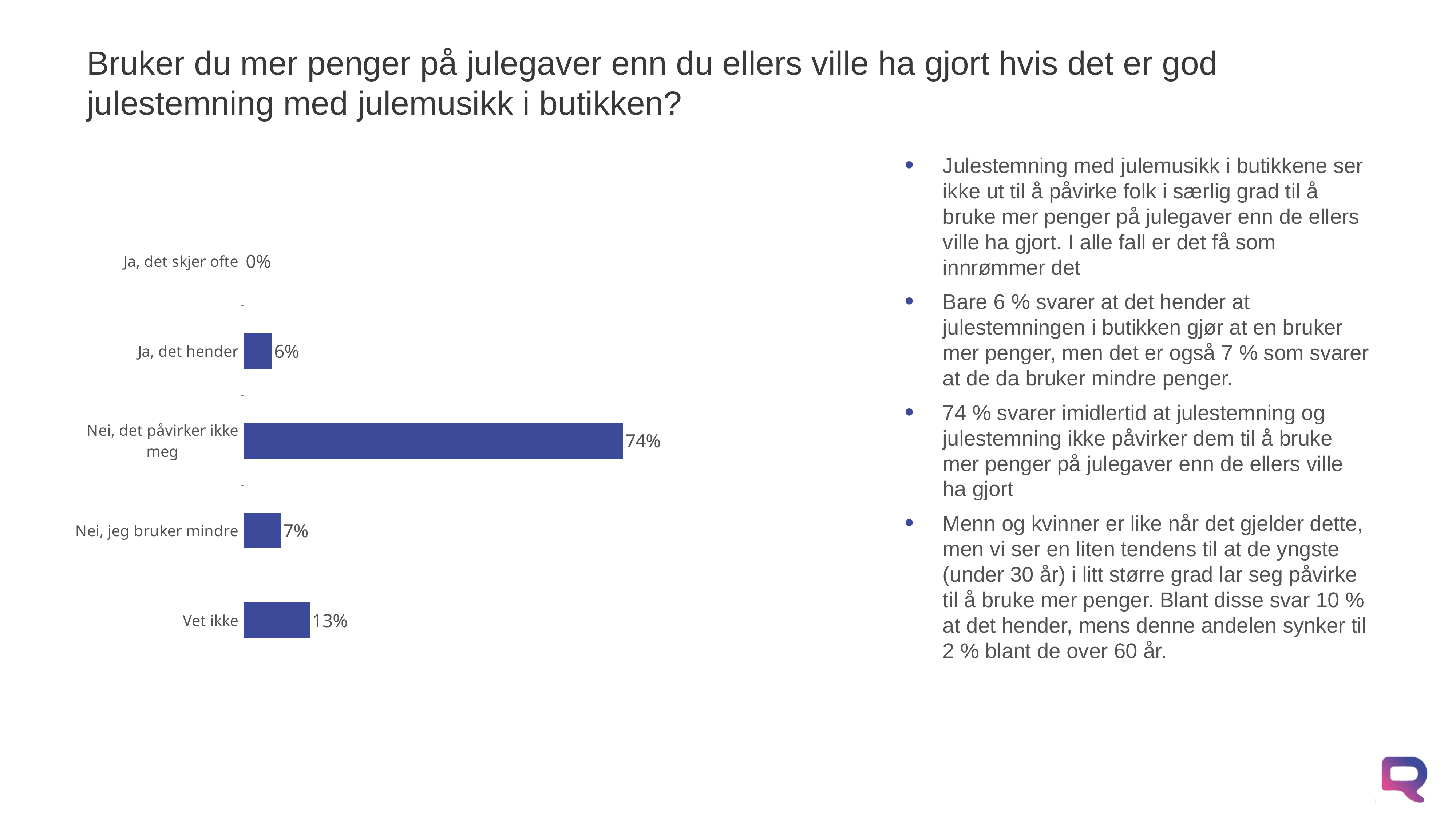
How many categories are shown in the chart? 5 What is the value for "Ja, det hender"? 6% What is the value for "Ja, det skjer ofte"? 0% Which is larger, the value for "Vet ikke" or the value for "Nei, jeg bruker mindre"? Vet ikke What is the difference between the values for "Nei, det påvirker ikke meg" and "Vet ikke"? 61% What is the difference between the values for "Nei, jeg bruker mindre" and "Ja, det hender"? 1% What is the value for "Vet ikke"? 13% What kind of chart is shown on the slide? Bar chart Which category has the lowest value? Ja, det skjer ofte Which category has the highest value? Nei, det påvirker ikke meg What is the value for "Nei, det påvirker ikke meg"? 74% What is the value for "Nei, jeg bruker mindre"? 7%